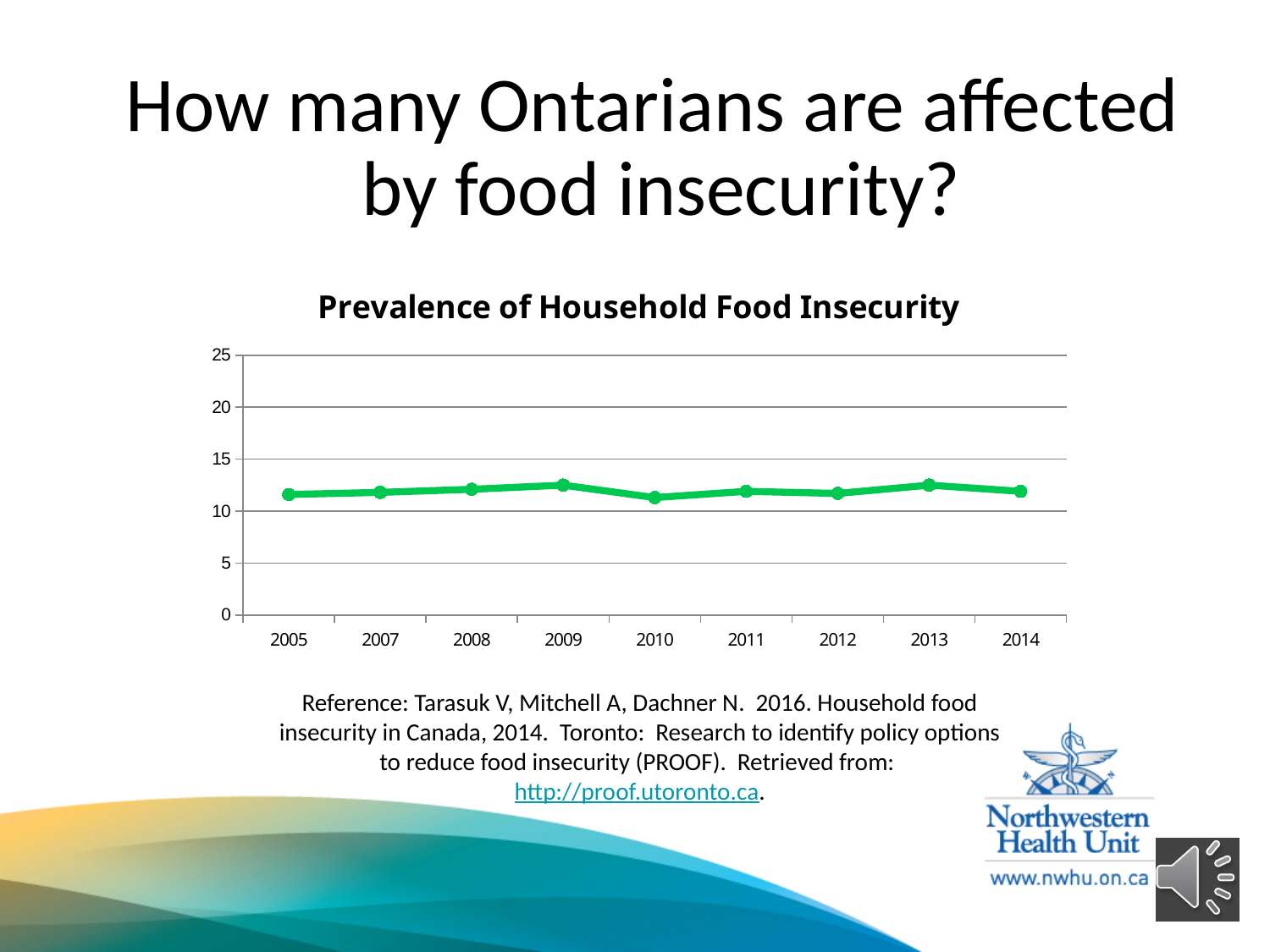
How many years are plotted on the x axis of the chart? 9 Is the value for 2013 greater or less than 20? less What kind of chart is shown on the slide? line chart Which is larger, the value for 2013 or the value for 2010? 2013 Is the value for 2010 greater or less than 10? greater What is the first year shown on the x axis? 2005 Is the value for 2005 greater or less than 10? greater What is the title of the chart? Prevalence of Household Food Insecurity Which is larger, the value for 2009 or the value for 2010? 2009 What is the highest value shown on the y axis? 25